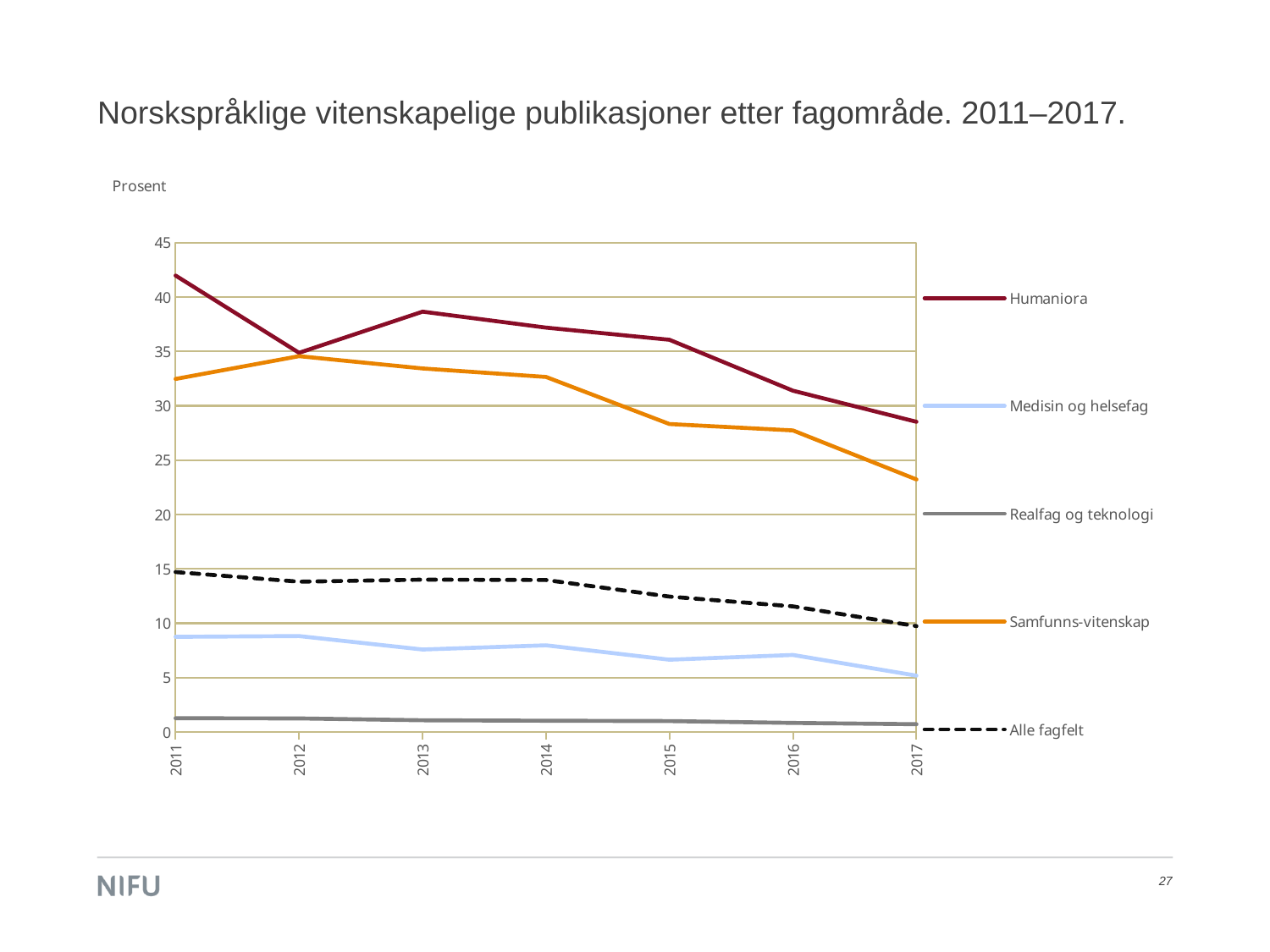
How many years are plotted along the x axis? 7 Does the Alle fagfelt line rise or fall from 2011 to 2017? fall Is the value for Humaniora in 2011 greater or less than 40? greater What kind of chart is shown on the slide? line chart Is the value for Medisin og helsefag in 2011 greater or less than 10? less Which series has the lowest value in 2017? Realfag og teknologi Which series has the highest value in 2011? Humaniora Is the value for Samfunns-vitenskap in 2017 greater or less than 25? less How many series does the legend list? 5 In 2013, which is larger: Humaniora or Samfunns-vitenskap? Humaniora What label is shown above the y axis? Prosent